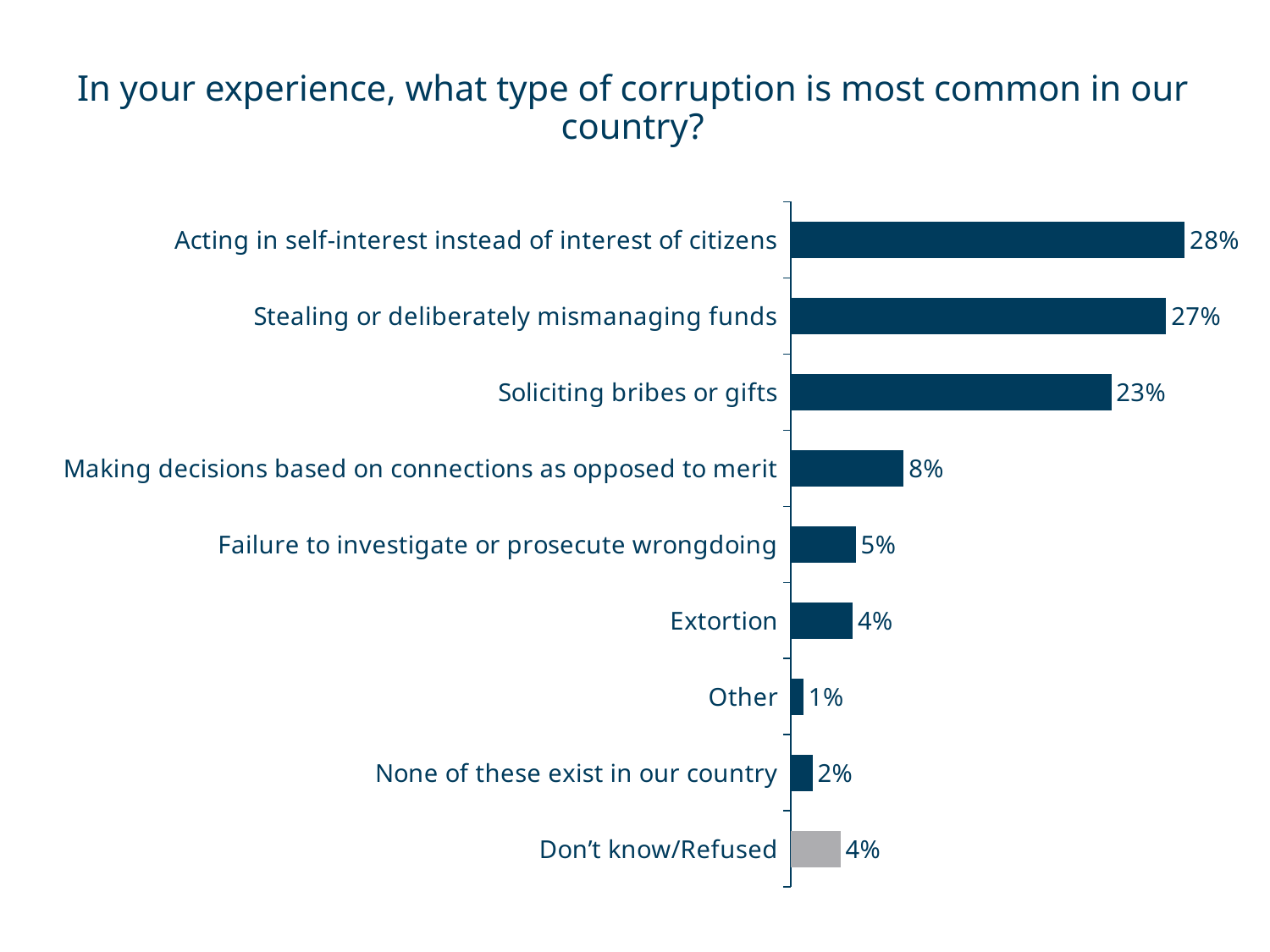
How many categories are shown in the chart? 9 Which category has the lowest value? Other What kind of chart is shown on the slide? Bar chart What percentage answered "Don't know/Refused"? 4% What is the value for "None of these exist in our country"? 2% What percentage of respondents chose "Soliciting bribes or gifts"? 23% Which is larger: "Failure to investigate or prosecute wrongdoing" or "Extortion"? Failure to investigate or prosecute wrongdoing Which bar is shown in a different colour (grey) from the others? Don't know/Refused Which category has the highest value? Acting in self-interest instead of interest of citizens What is the difference between "Acting in self-interest instead of interest of citizens" and "Stealing or deliberately mismanaging funds"? 1% What is the value for "Making decisions based on connections as opposed to merit"? 8% What is the difference between "Soliciting bribes or gifts" and "Extortion"? 19%